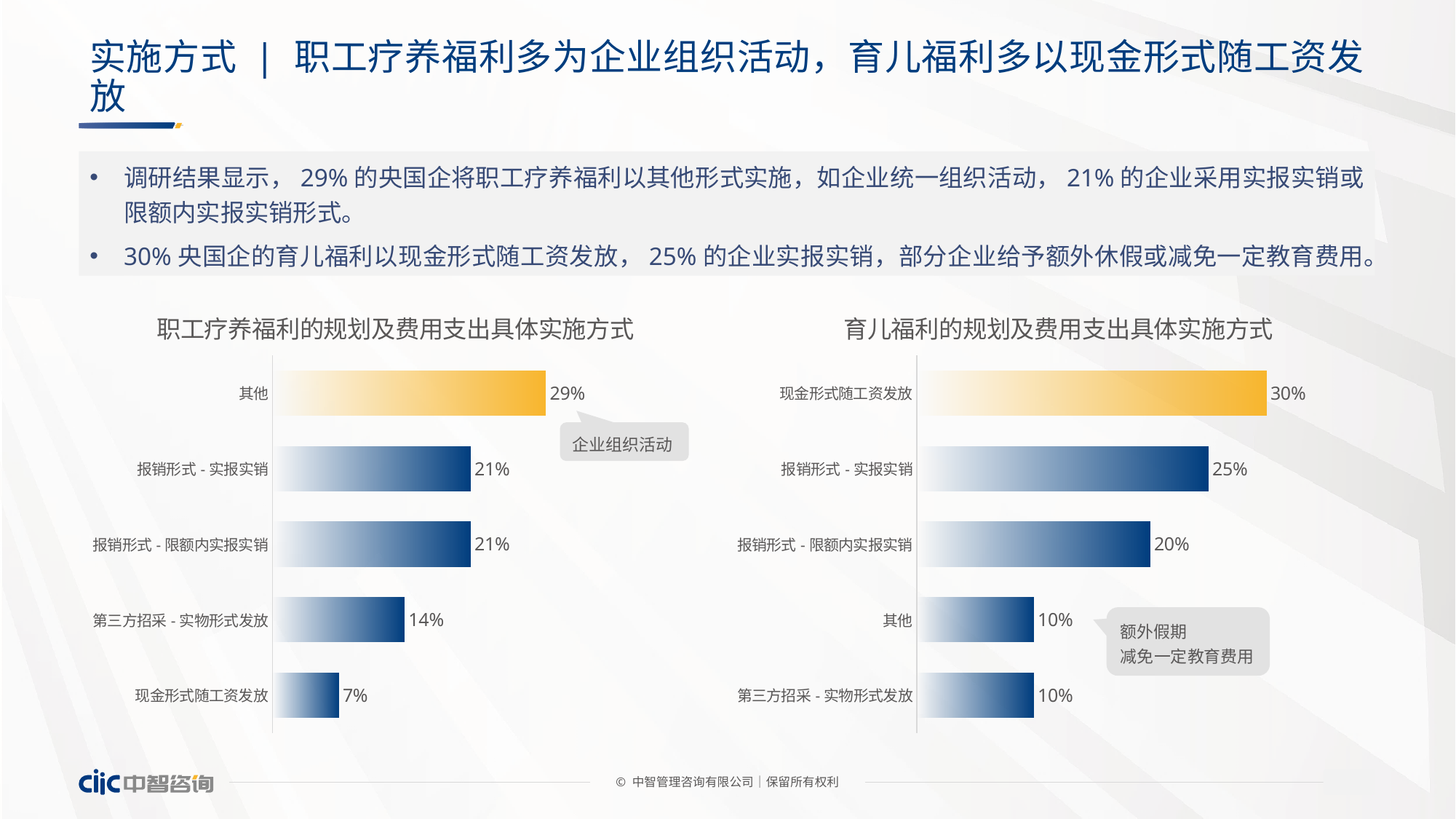
In the left chart (职工疗养福利的规划及费用支出具体实施方式), what is the difference between 其他 and 第三方招采 - 实物形式发放? 15% In the right chart (育儿福利的规划及费用支出具体实施方式), what does the callout next to 其他 say? 额外假期 减免一定教育费用 In the right chart (育儿福利的规划及费用支出具体实施方式), which is larger: 报销形式 - 实报实销 or 报销形式 - 限额内实报实销? 报销形式 - 实报实销 In the left chart (职工疗养福利的规划及费用支出具体实施方式), what is the value for 现金形式随工资发放? 7% In the right chart (育儿福利的规划及费用支出具体实施方式), what is the difference between 报销形式 - 实报实销 and 其他? 15% In the left chart (职工疗养福利的规划及费用支出具体实施方式), what is the value for 其他? 29% In the right chart (育儿福利的规划及费用支出具体实施方式), what is the value for 现金形式随工资发放? 30% What type of chart is the left chart (职工疗养福利的规划及费用支出具体实施方式)? Bar chart In the right chart (育儿福利的规划及费用支出具体实施方式), which category has the highest value? 现金形式随工资发放 In the left chart (职工疗养福利的规划及费用支出具体实施方式), which category has the lowest value? 现金形式随工资发放 In the left chart (职工疗养福利的规划及费用支出具体实施方式), how many categories are shown? 5 In the right chart (育儿福利的规划及费用支出具体实施方式), what is the value for 报销形式 - 限额内实报实销? 20%